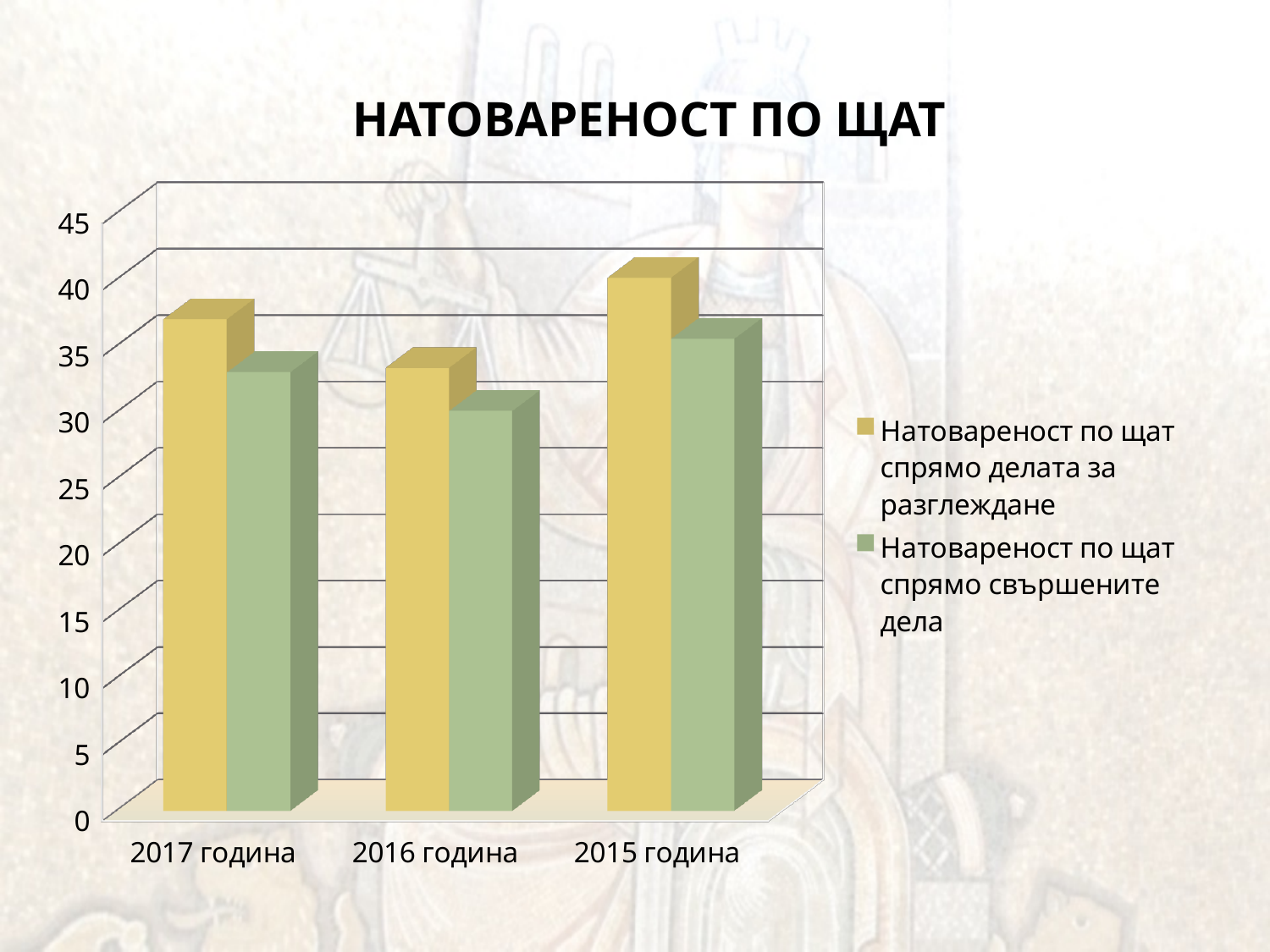
What is the title of the chart? НАТОВАРЕНОСТ ПО ЩАТ In 2017 година, which series has the larger value: 'Натовареност по щат спрямо делата за разглеждане' or 'Натовареност по щат спрямо свършените дела'? Натовареност по щат спрямо делата за разглеждане Is the value for 'Натовареност по щат спрямо свършените дела' in 2017 година greater or less than 30? greater How many series does the legend list? 2 How many categories are shown on the x axis? 3 Which series is shown in green? Натовареност по щат спрямо свършените дела Which category has the lowest value for 'Натовареност по щат спрямо делата за разглеждане'? 2016 година Which category has the lowest value for 'Натовареност по щат спрямо свършените дела'? 2016 година Which category has the highest value for 'Натовареност по щат спрямо делата за разглеждане'? 2015 година Is the value for 'Натовареност по щат спрямо делата за разглеждане' in 2016 година greater or less than 35? less What type of chart is shown on the slide? bar chart Is the value for 'Натовареност по щат спрямо делата за разглеждане' in 2017 година greater or less than 35? greater